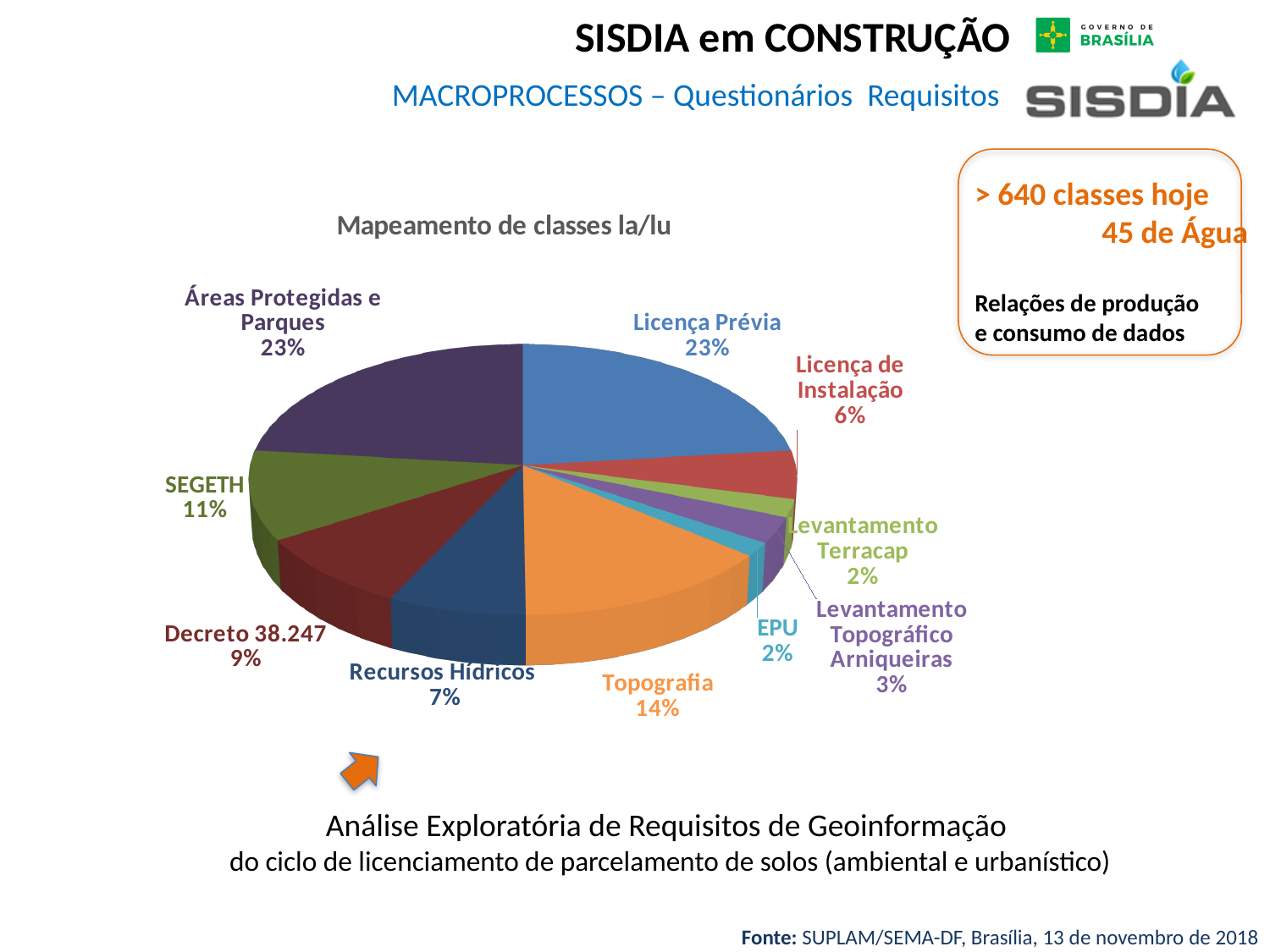
What share does Levantamento Topográfico Arniqueiras have? 3% What type of chart is shown on the slide? pie chart Which is larger, Topografia or SEGETH? Topografia What is the difference between the shares of Topografia and Licença de Instalação? 8% Which is larger, Decreto 38.247 or Recursos Hídricos? Decreto 38.247 What is the value for Licença de Instalação? 6% How many slices does the pie chart have? 10 What is the difference between the shares of Licença Prévia and Recursos Hídricos? 16% What percentage is shown for SEGETH? 11% What percentage is shown for Decreto 38.247? 9% What share of the pie does Topografia represent? 14% What is the title of the pie chart? Mapeamento de classes la/lu